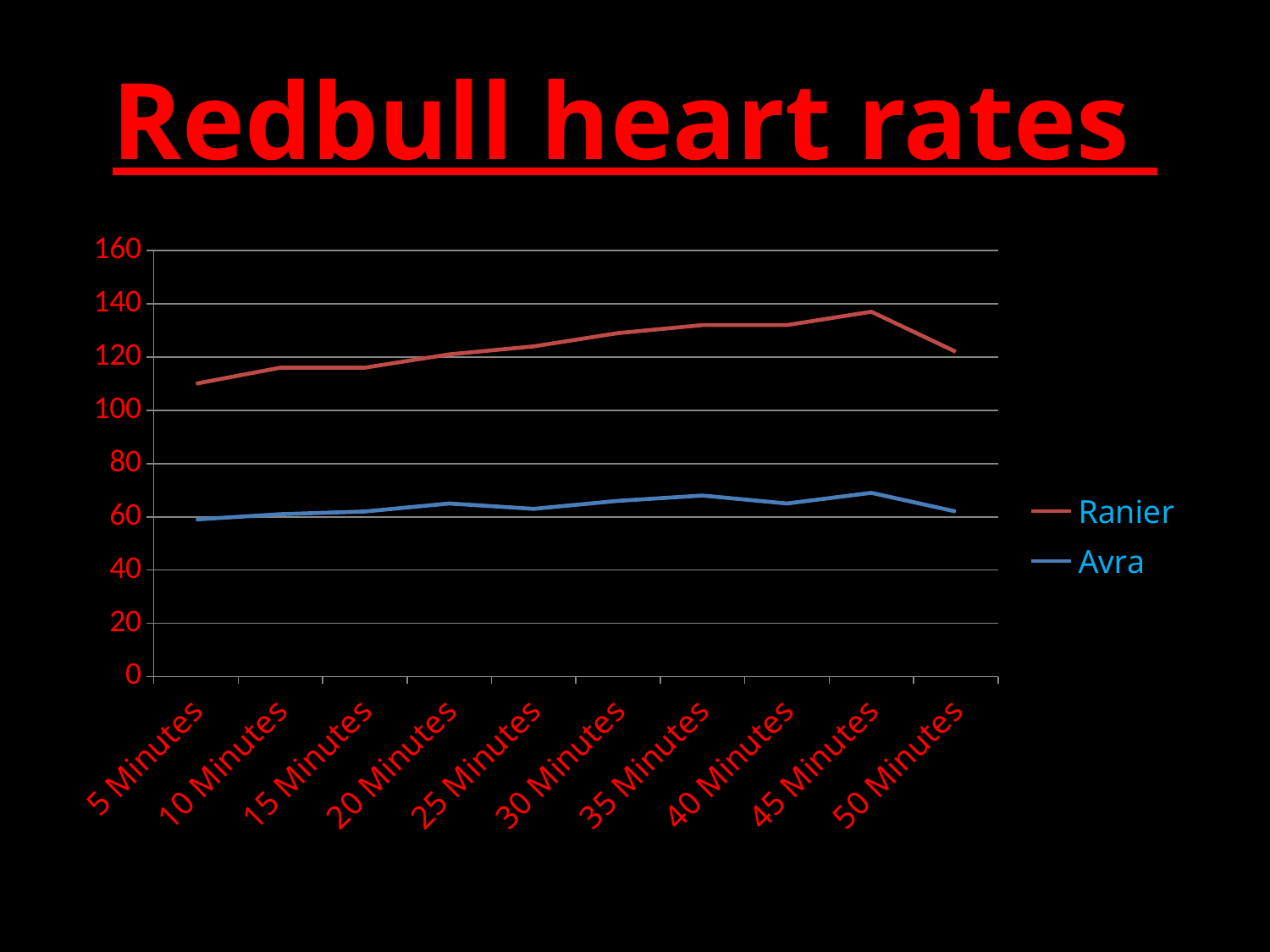
At which time point does Ranier's heart rate reach its highest value? 45 Minutes How many time points are plotted along the x axis? 10 Does Ranier's line rise or fall between 45 Minutes and 50 Minutes? fall How many series does the legend list? 2 At which time point is Ranier's heart rate lowest? 5 Minutes Does Ranier's line generally rise or fall from 5 Minutes to 45 Minutes? rise Is Avra's value at 35 Minutes greater or less than 60? greater Which series has the higher heart rate at 30 Minutes, Ranier or Avra? Ranier What is the title of the slide? Redbull heart rates Is Ranier's value at 5 Minutes greater or less than 120? less What kind of chart is shown on the slide? Line chart Is Ranier's value at 45 Minutes greater or less than 120? greater